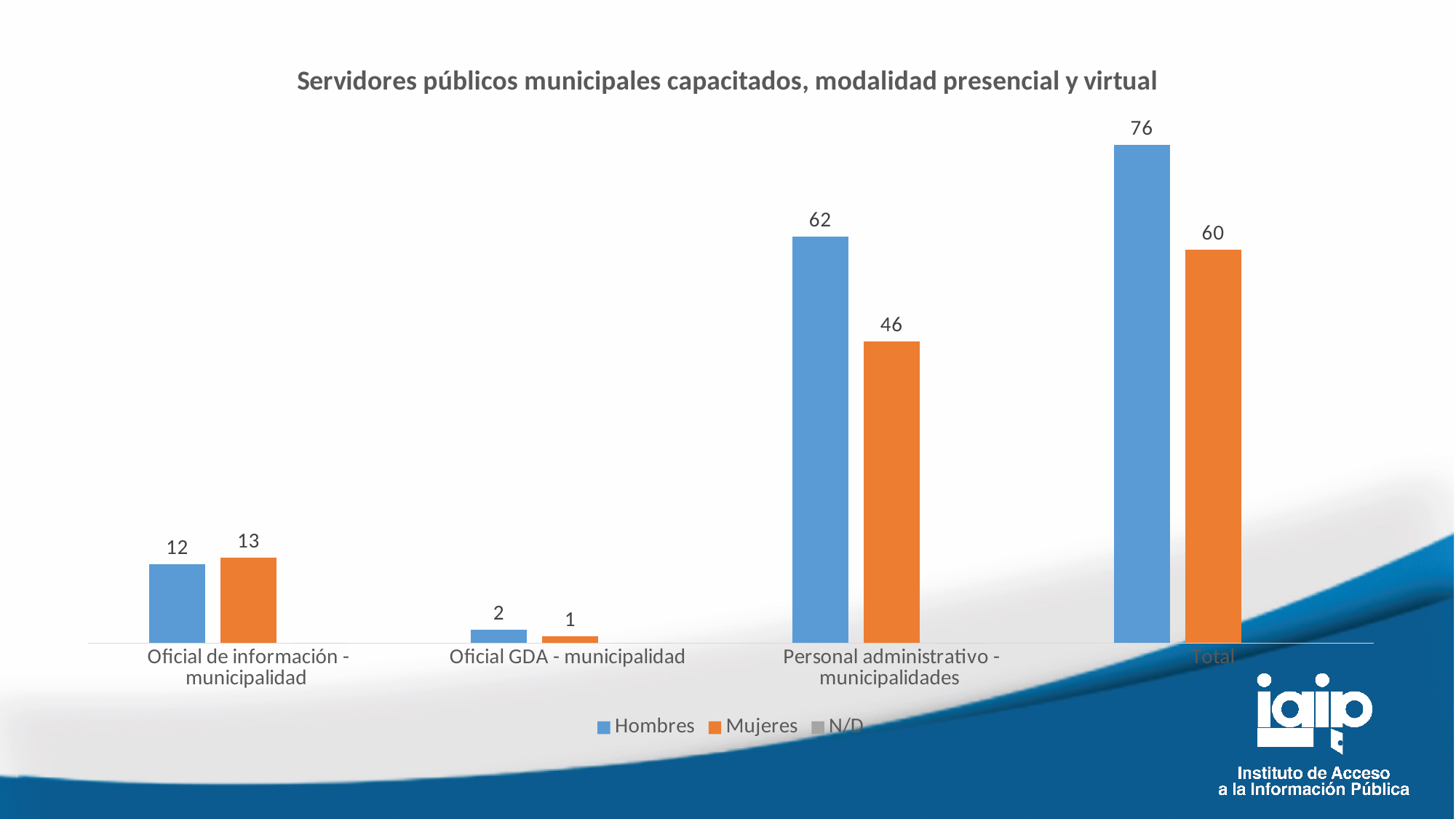
How many categories are shown on the x axis? 4 What is the value for Hombres in the Total category? 76 Which category has the highest value for Mujeres? Total How many series does the legend list? 3 What is the title of the chart? Servidores públicos municipales capacitados, modalidad presencial y virtual In the Oficial de información - municipalidad category, which is larger, Hombres or Mujeres? Mujeres What kind of chart is shown on the slide? Bar chart What is the value for Hombres in the Oficial de información - municipalidad category? 12 Excluding Total, which category has the lowest value for Hombres? Oficial GDA - municipalidad What is the difference between Hombres and Mujeres in the Personal administrativo - municipalidades category? 16 What is the value for Mujeres in the Personal administrativo - municipalidades category? 46 What is the value for Mujeres in the Oficial GDA - municipalidad category? 1